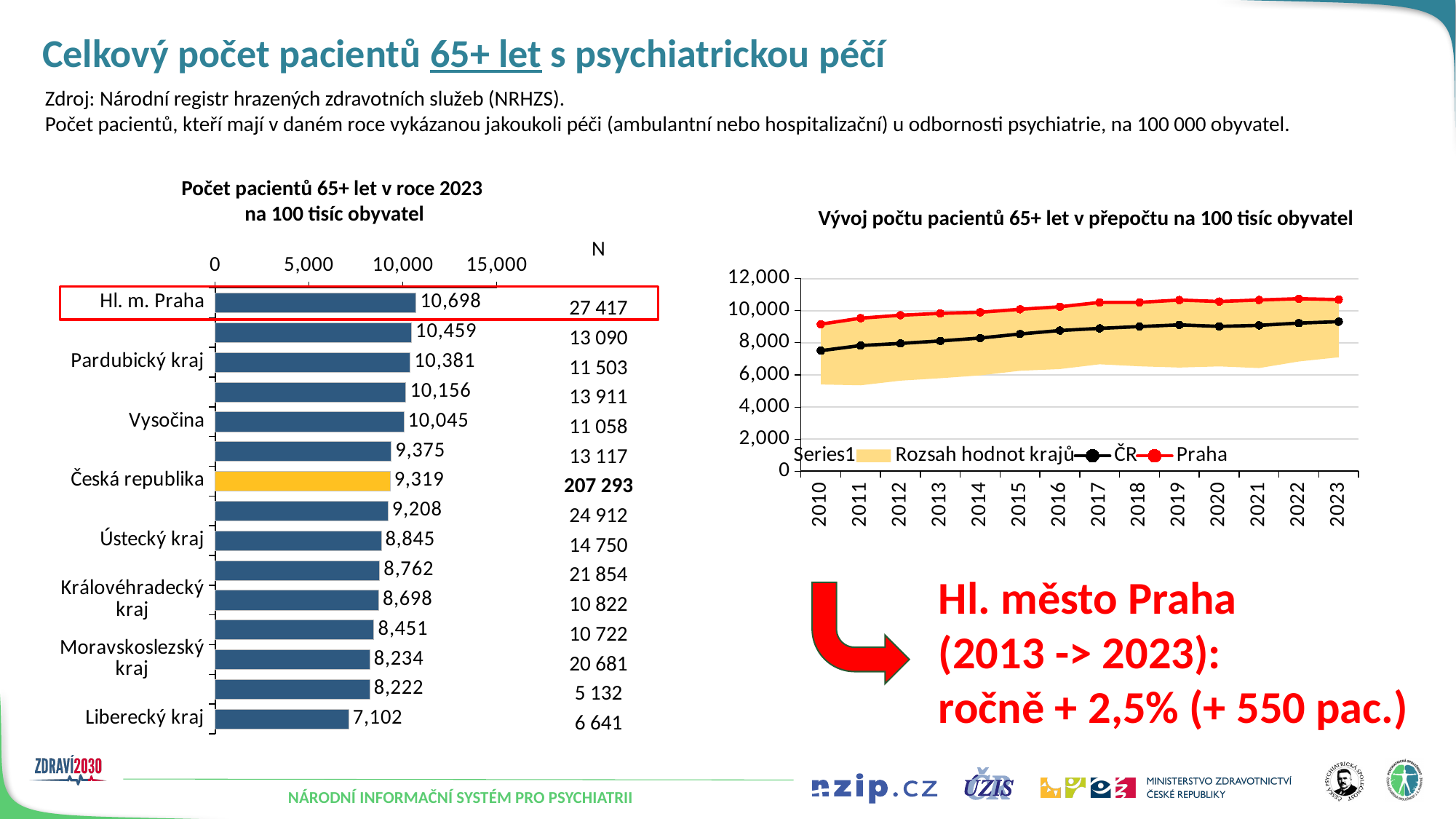
How many bars are plotted in the bar chart 'Počet pacientů 65+ let v roce 2023 na 100 tisíc obyvatel'? 15 In the bar chart 'Počet pacientů 65+ let v roce 2023 na 100 tisíc obyvatel', what is the value for Česká republika? 9,319 What kind of chart is the left chart 'Počet pacientů 65+ let v roce 2023 na 100 tisíc obyvatel'? Bar chart In the bar chart 'Počet pacientů 65+ let v roce 2023 na 100 tisíc obyvatel', which has a larger value, Pardubický kraj or Vysočina? Pardubický kraj In the bar chart 'Počet pacientů 65+ let v roce 2023 na 100 tisíc obyvatel', what is the difference between the values for Hl. m. Praha and Liberecký kraj? 3,596 In the bar chart 'Počet pacientů 65+ let v roce 2023 na 100 tisíc obyvatel', what is the value for Hl. m. Praha? 10,698 In the chart 'Vývoj počtu pacientů 65+ let v přepočtu na 100 tisíc obyvatel', does the ČR line rise or fall from 2010 to 2023? Rises In the bar chart 'Počet pacientů 65+ let v roce 2023 na 100 tisíc obyvatel', what is the value for Liberecký kraj? 7,102 In the bar chart 'Počet pacientů 65+ let v roce 2023 na 100 tisíc obyvatel', which category has the highest value? Hl. m. Praha How many entries does the legend of the chart 'Vývoj počtu pacientů 65+ let v přepočtu na 100 tisíc obyvatel' list? 4 In the bar chart 'Počet pacientů 65+ let v roce 2023 na 100 tisíc obyvatel', which category has the lowest value? Liberecký kraj In the chart 'Vývoj počtu pacientů 65+ let v přepočtu na 100 tisíc obyvatel', is the value for Praha in 2010 greater or less than 8,000? greater